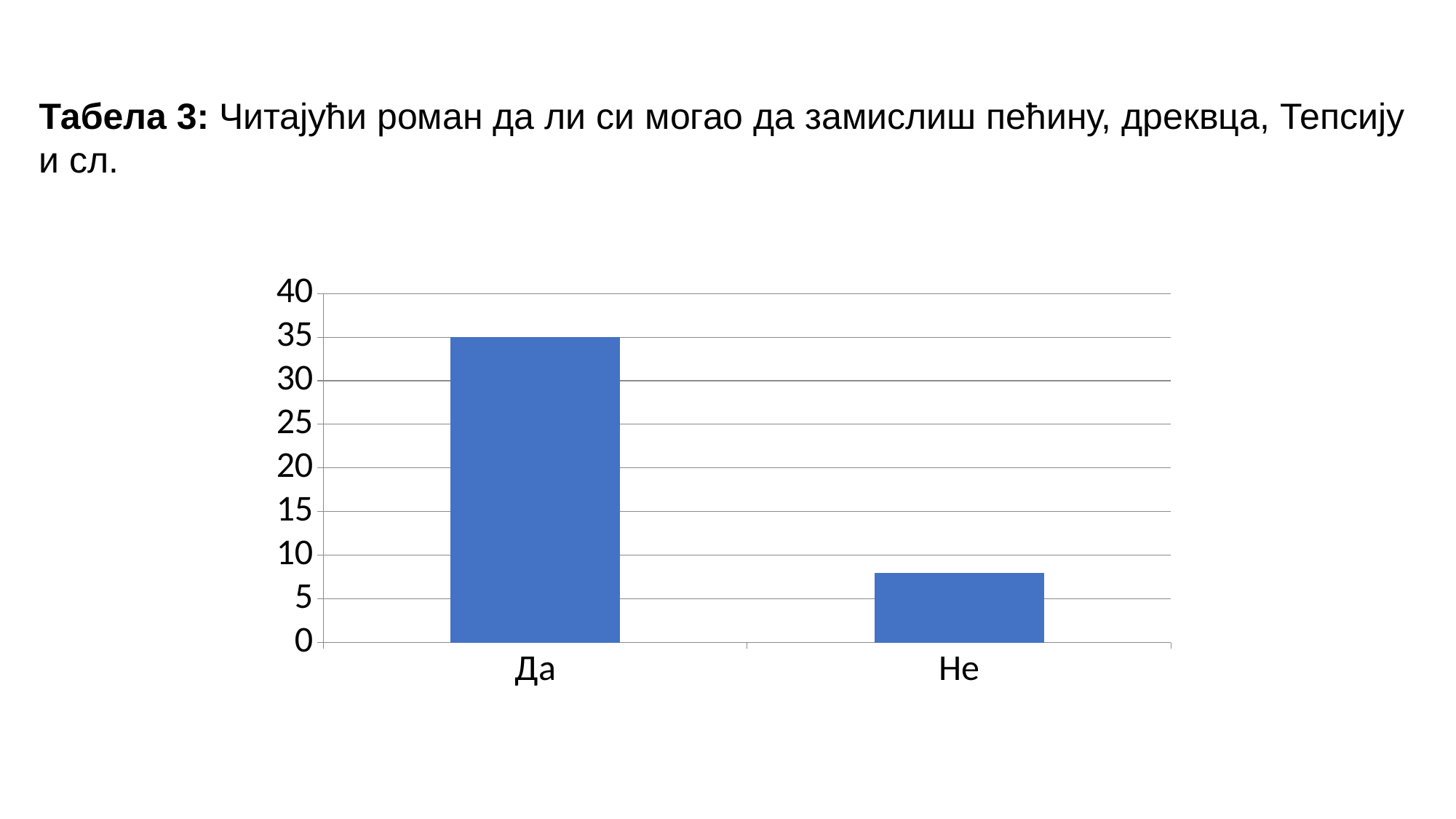
What kind of chart is shown on the slide? bar chart Is the value for Да greater or less than 30? greater What is the value for Да in the chart? 35 Which category has the highest bar in the chart? Да What is the highest value shown on the vertical axis of the chart? 40 Which is larger, the value for Да or the value for Не? Да What colour are the bars in the chart? blue How many categories are shown on the x axis of the chart? 2 Is the value for Не greater or less than 10? less Which category has the lowest bar in the chart? Не Is the value for Не greater or less than 5? greater